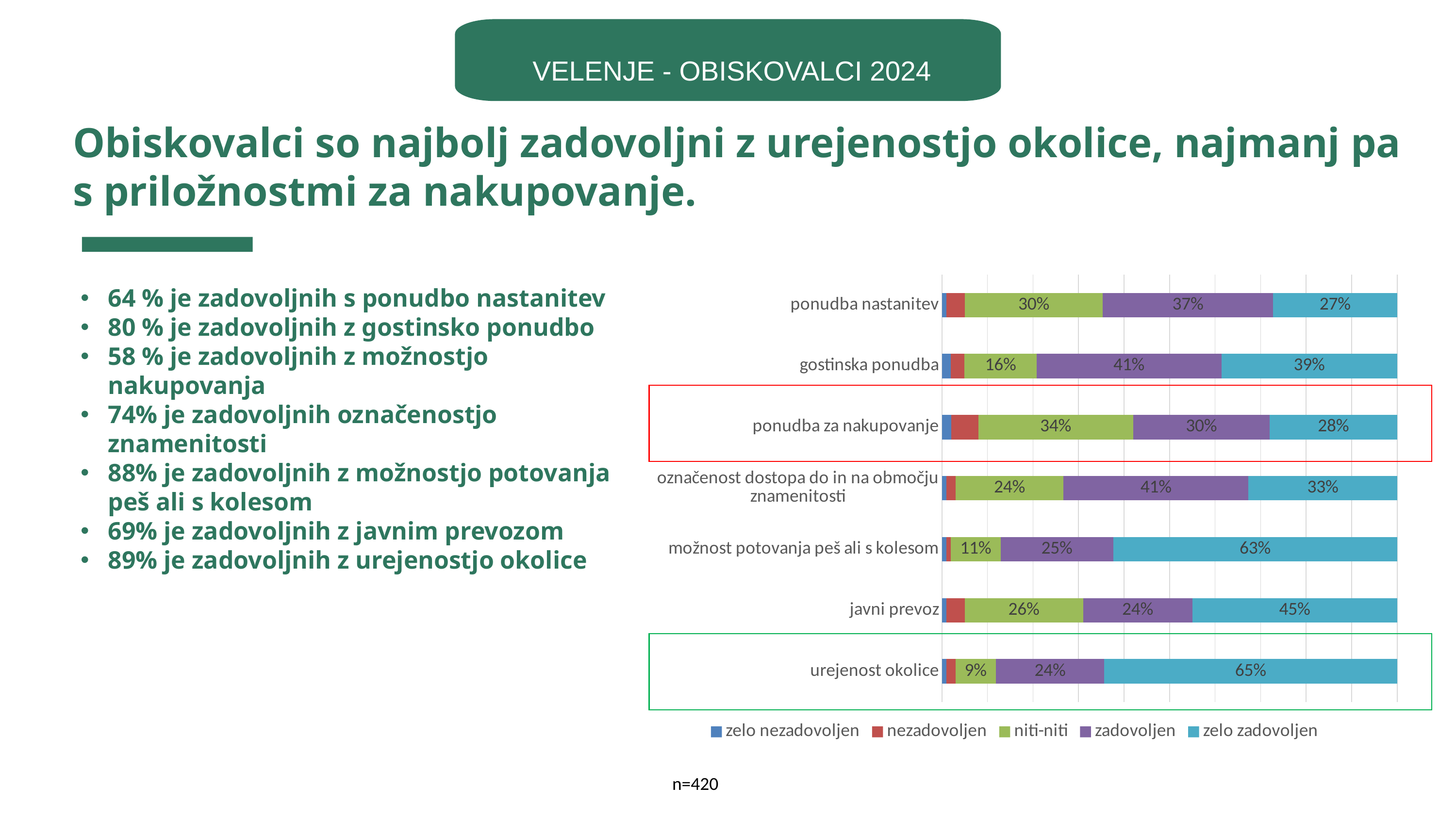
What is the 'zelo zadovoljen' value for 'urejenost okolice'? 65% What is the 'zelo zadovoljen' value for 'javni prevoz'? 45% How many categories are plotted on the chart? 7 Which category has the highest 'zelo zadovoljen' value? urejenost okolice What is the difference between the 'zelo zadovoljen' values for 'urejenost okolice' and 'ponudba za nakupovanje'? 37% Which is larger: the 'zadovoljen' value for 'ponudba nastanitev' or for 'javni prevoz'? ponudba nastanitev What is the 'zadovoljen' value for 'gostinska ponudba'? 41% Which category has the lowest 'niti-niti' value? urejenost okolice Which legend entry is shown in purple? zadovoljen What kind of chart is shown on the slide? stacked bar chart What is the 'niti-niti' value for 'ponudba za nakupovanje'? 34% How many series does the chart legend list? 5